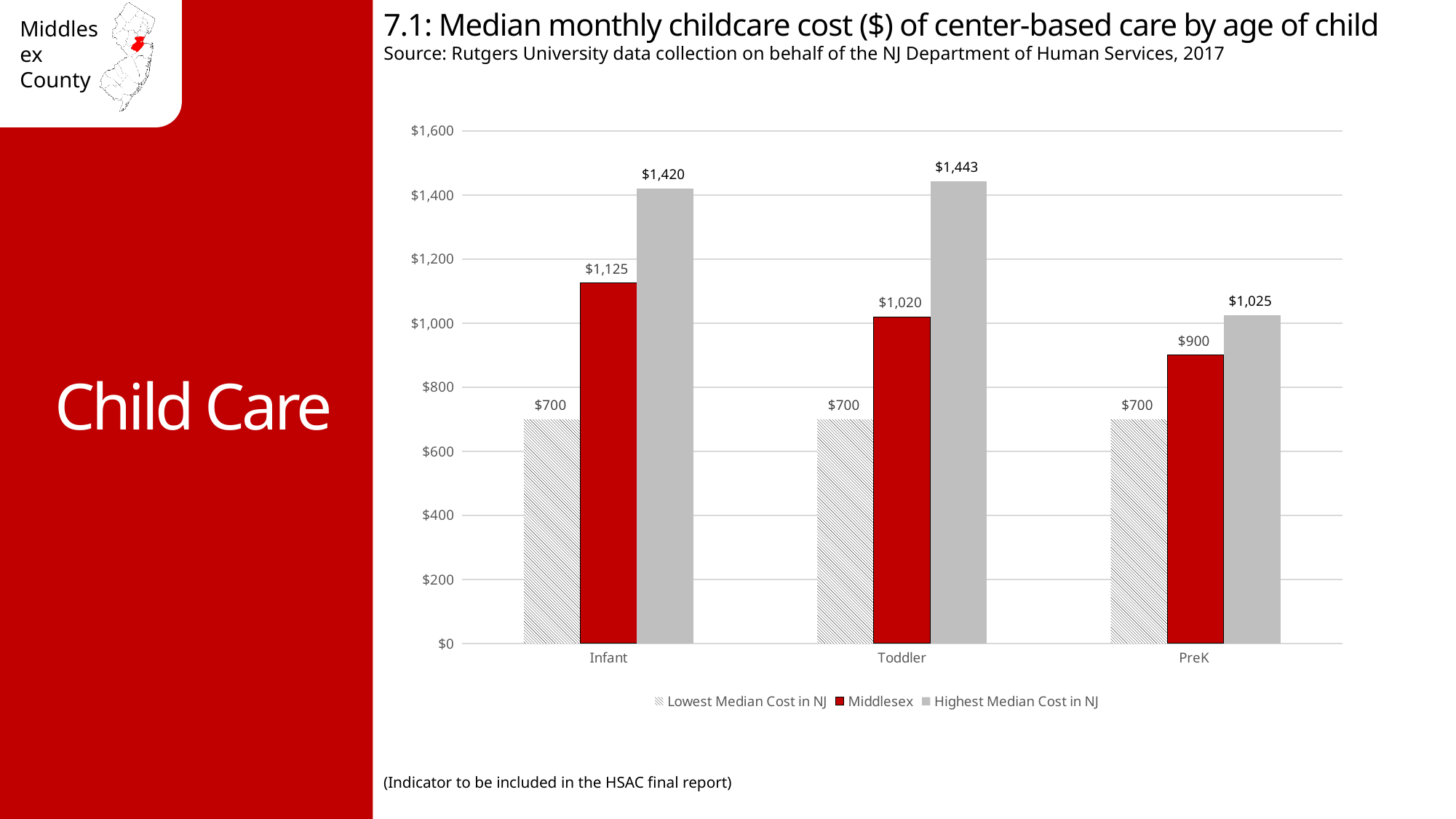
How many series does the legend list? 3 How many age groups are shown on the x axis? 3 What kind of chart is shown on the slide? Bar chart Which is larger: the Middlesex cost for Toddler care or the Middlesex cost for PreK care? Toddler Which age group has the highest Middlesex median monthly cost? Infant Does the Middlesex median monthly cost rise or fall from Infant to PreK? Fall Is the Highest Median Cost in NJ for PreK care greater or less than $1,000? greater What is the difference between the Highest Median Cost in NJ and the Middlesex cost for Infant care? $295 Which age group has the lowest Highest Median Cost in NJ? PreK What is the Highest Median Cost in NJ for Toddler care? $1,443 What is the Middlesex median monthly childcare cost for Infant care? $1,125 What is the Lowest Median Cost in NJ for PreK care? $700